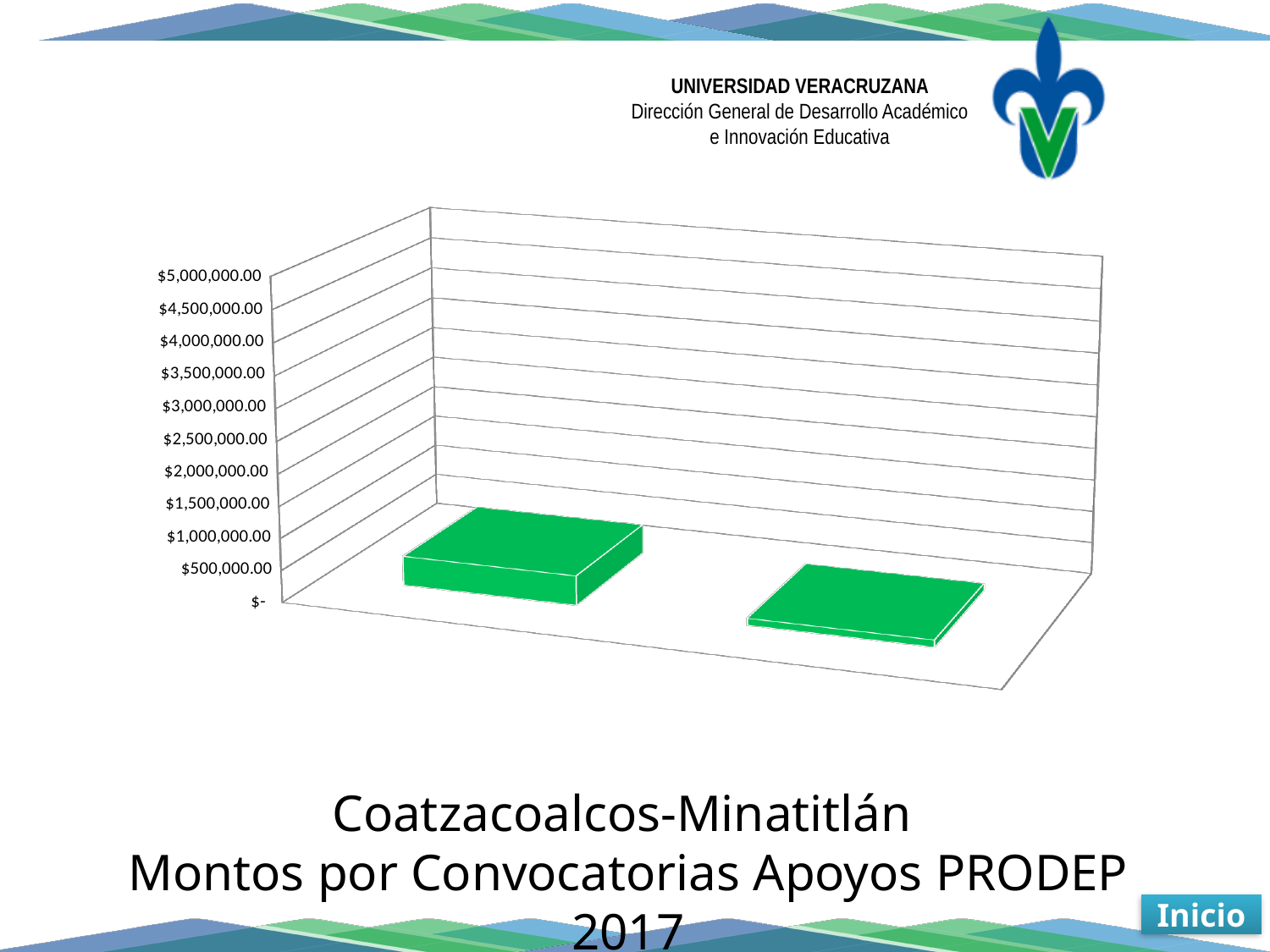
How many bars are plotted in the chart? 2 What colour are the bars in the chart? green Which bar has the highest value? the left bar Which bar has the lowest value? the right bar Is the value of the left bar greater or less than $1,000,000.00? less Do the bar values rise or fall from left to right? fall What is the highest value shown on the vertical axis? $5,000,000.00 Is the value of the right bar greater or less than $500,000.00? less What kind of chart is shown on the slide? bar chart Which bar is taller, the left bar or the right bar? the left bar